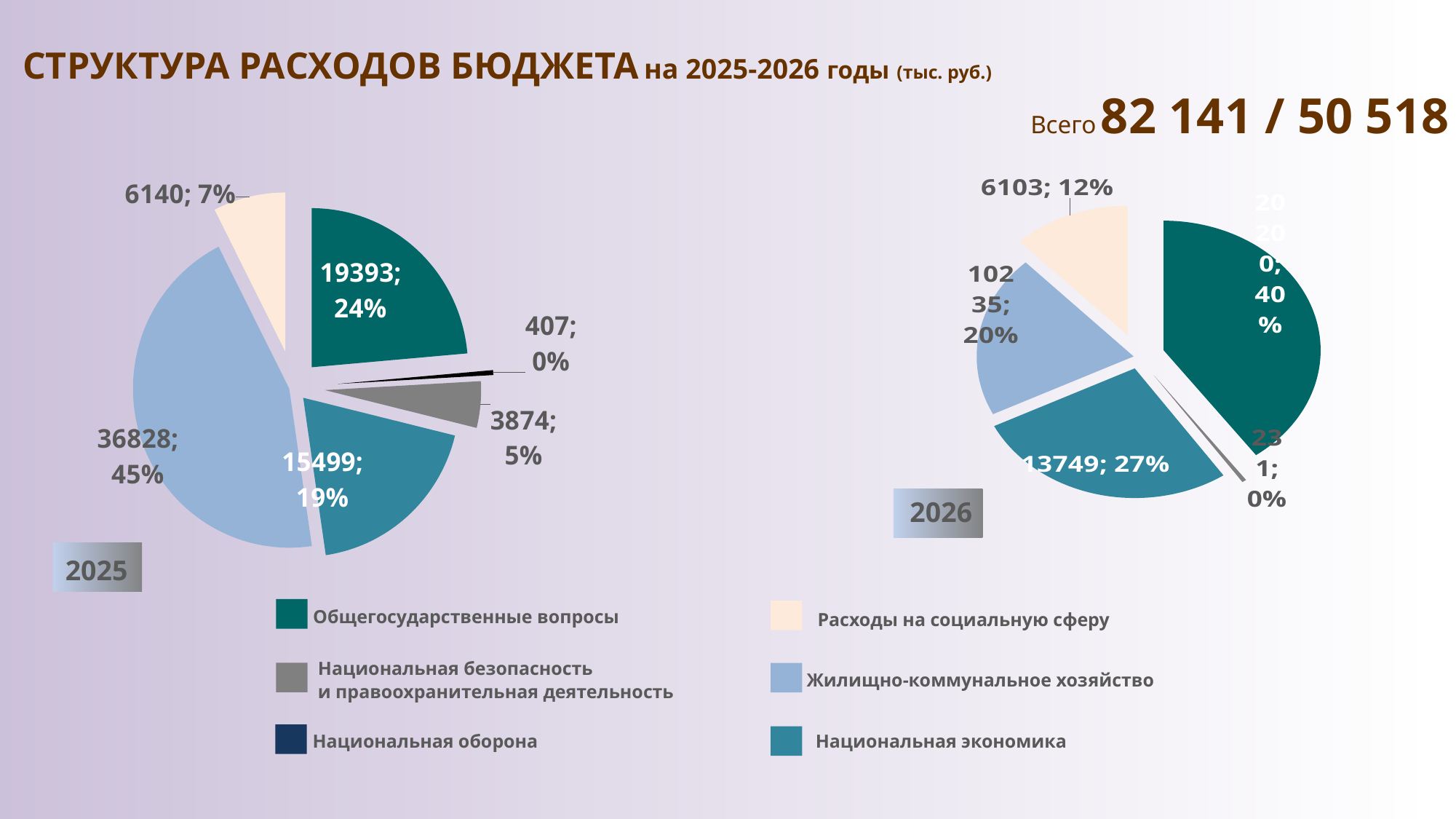
In the 2025 pie chart, what value is shown for Общегосударственные вопросы? 19393 In the 2026 pie chart, what share does Общегосударственные вопросы have? 40% What kind of charts are shown on the slide? Pie charts In the 2025 pie chart, what share does Расходы на социальную сферу have? 7% In the 2026 pie chart, what value is shown for Национальная экономика? 13749; 27% In the 2025 pie chart, what is the difference between Жилищно-коммунальное хозяйство (36828) and Общегосударственные вопросы (19393)? 17435 In the 2026 pie chart, which is larger: Национальная экономика or Жилищно-коммунальное хозяйство? Национальная экономика In the 2025 pie chart, which category has the smallest slice? Национальная оборона How many categories does the legend list? 6 In the 2026 pie chart, which category has the largest slice? Общегосударственные вопросы In the 2025 pie chart, what value is shown for Жилищно-коммунальное хозяйство? 36828; 45% In the 2025 pie chart, which category has the largest slice? Жилищно-коммунальное хозяйство